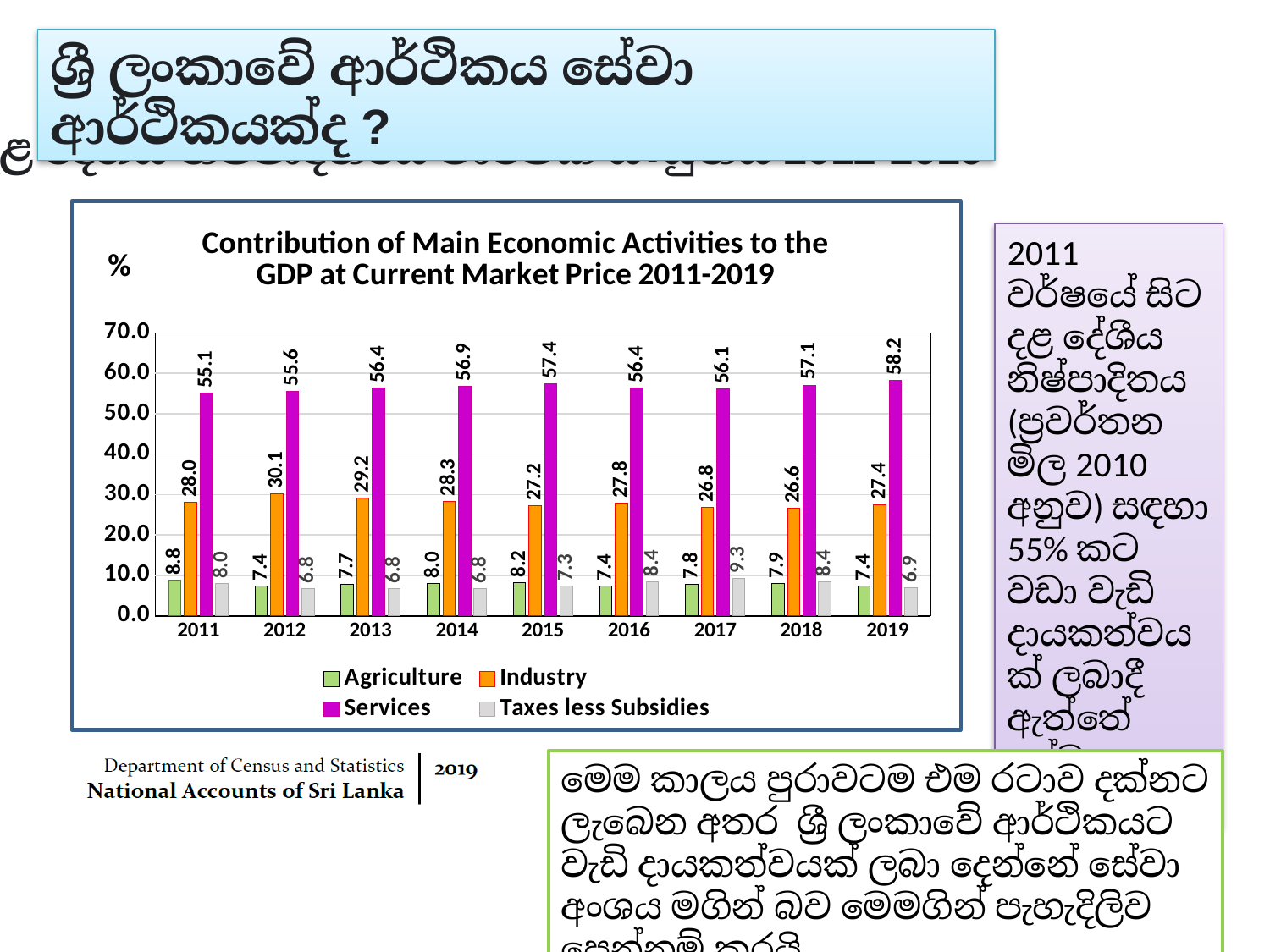
What is the value for Agriculture in 2011? 8.8 In which year is the Industry value lowest? 2018 What is the value for Services in 2019? 58.2 In which year is the Services value highest? 2019 What is the value for Industry in 2012? 30.1 How many years are shown on the x axis? 9 How many series does the legend list? 4 Is the value for Industry in 2013 greater or less than 30.0? less Which is larger in 2015: Agriculture or Taxes less Subsidies? Agriculture What is the difference between the Services value in 2019 and in 2011? 3.1 What is the value for Taxes less Subsidies in 2017? 9.3 What kind of chart is shown? bar chart